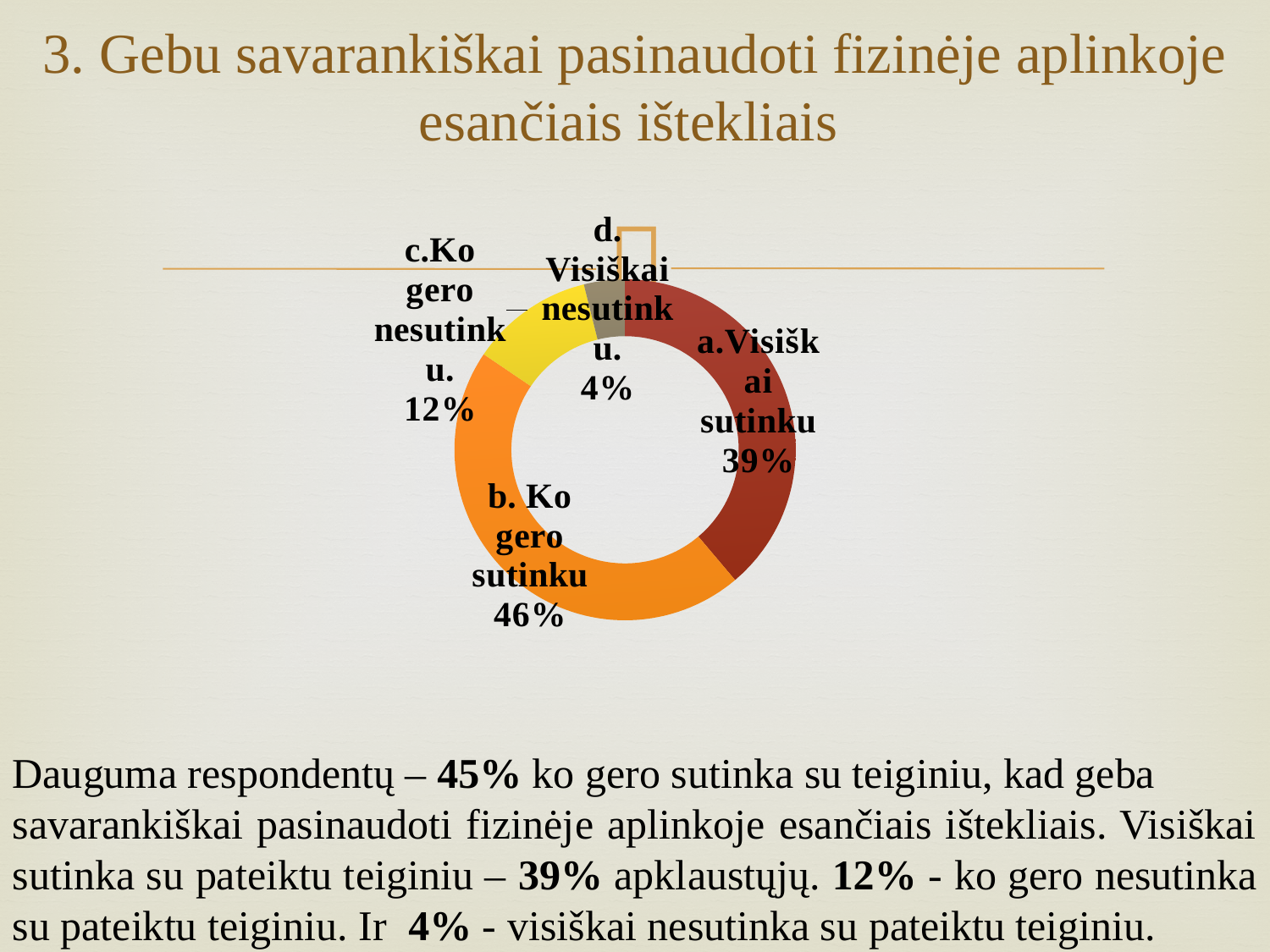
Which category has the smallest share of the chart? d. Visiškai nesutinku What percentage is shown for "a. Visiškai sutinku"? 39% What is the difference in percentage points between "b. Ko gero sutinku" and "a. Visiškai sutinku"? 7 What percentage is shown for "c. Ko gero nesutinku"? 12% What colour is the segment for "b. Ko gero sutinku"? orange Which category has the largest share of the chart? b. Ko gero sutinku What kind of chart is shown on the slide? doughnut chart Which is larger: the share for "c. Ko gero nesutinku" or for "d. Visiškai nesutinku"? c. Ko gero nesutinku What percentage is shown for "b. Ko gero sutinku"? 46% What is the combined percentage of "a. Visiškai sutinku" and "b. Ko gero sutinku"? 85% How many categories does the chart show? 4 What percentage is shown for "d. Visiškai nesutinku"? 4%